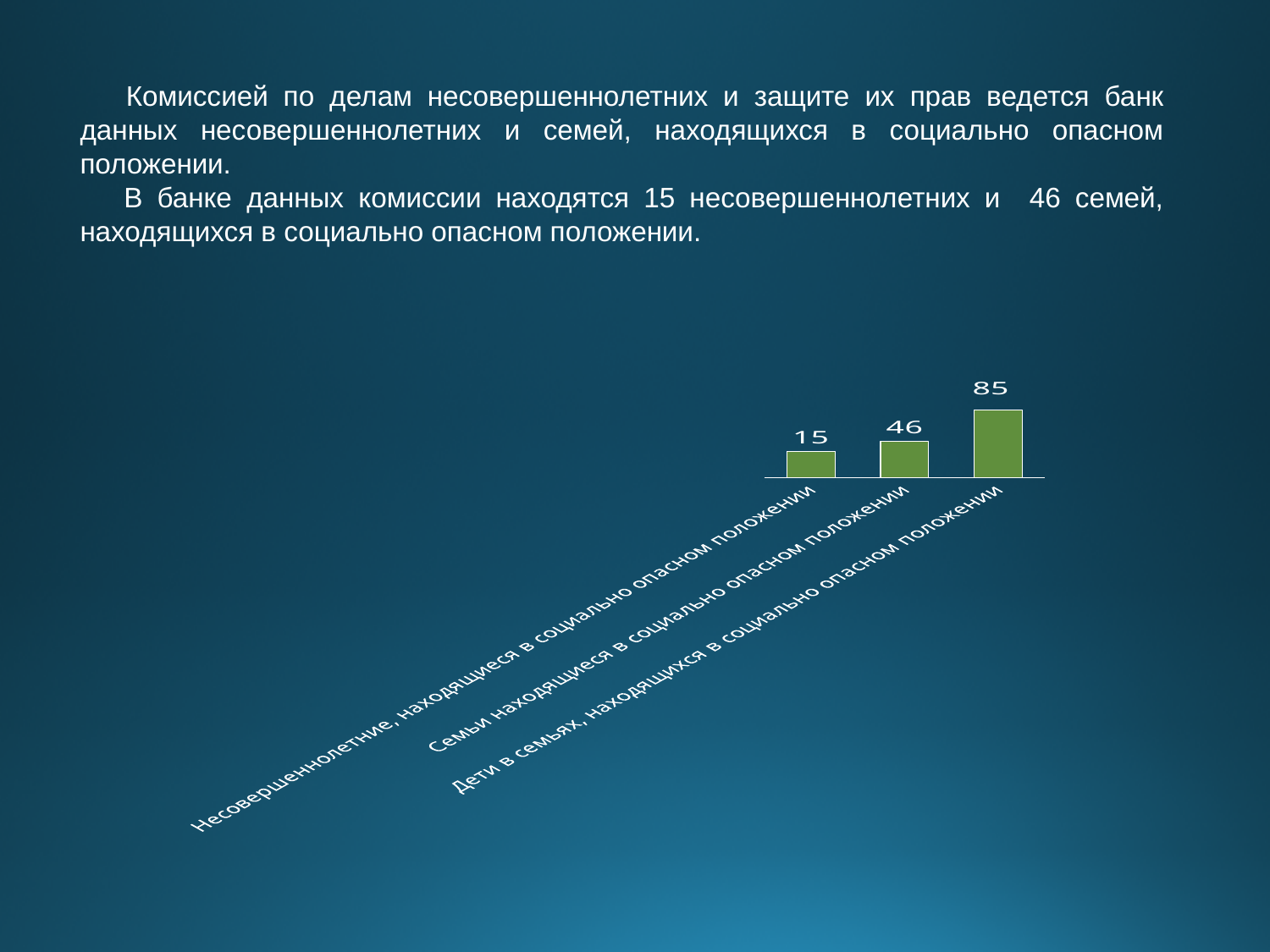
What is the difference between the value for «Семьи, находящиеся в социально опасном положении» and the value for «Несовершеннолетние, находящиеся в социально опасном положении»? 31 Which category has the highest value? Дети в семьях, находящихся в социально опасном положении What is the difference between the value for «Дети в семьях, находящихся в социально опасном положении» and the value for «Семьи, находящиеся в социально опасном положении»? 39 How many categories are shown in the chart? 3 What is the value for «Несовершеннолетние, находящиеся в социально опасном положении»? 15 What colour are the bars in the chart? Green What kind of chart is shown on the slide? Bar chart What is the value for «Семьи, находящиеся в социально опасном положении»? 46 What is the value for «Дети в семьях, находящихся в социально опасном положении»? 85 Which is larger: the value for «Семьи, находящиеся в социально опасном положении» or the value for «Несовершеннолетние, находящиеся в социально опасном положении»? Семьи, находящиеся в социально опасном положении Which category has the lowest value? Несовершеннолетние, находящиеся в социально опасном положении Do the values rise or fall from left to right across the categories? Rise